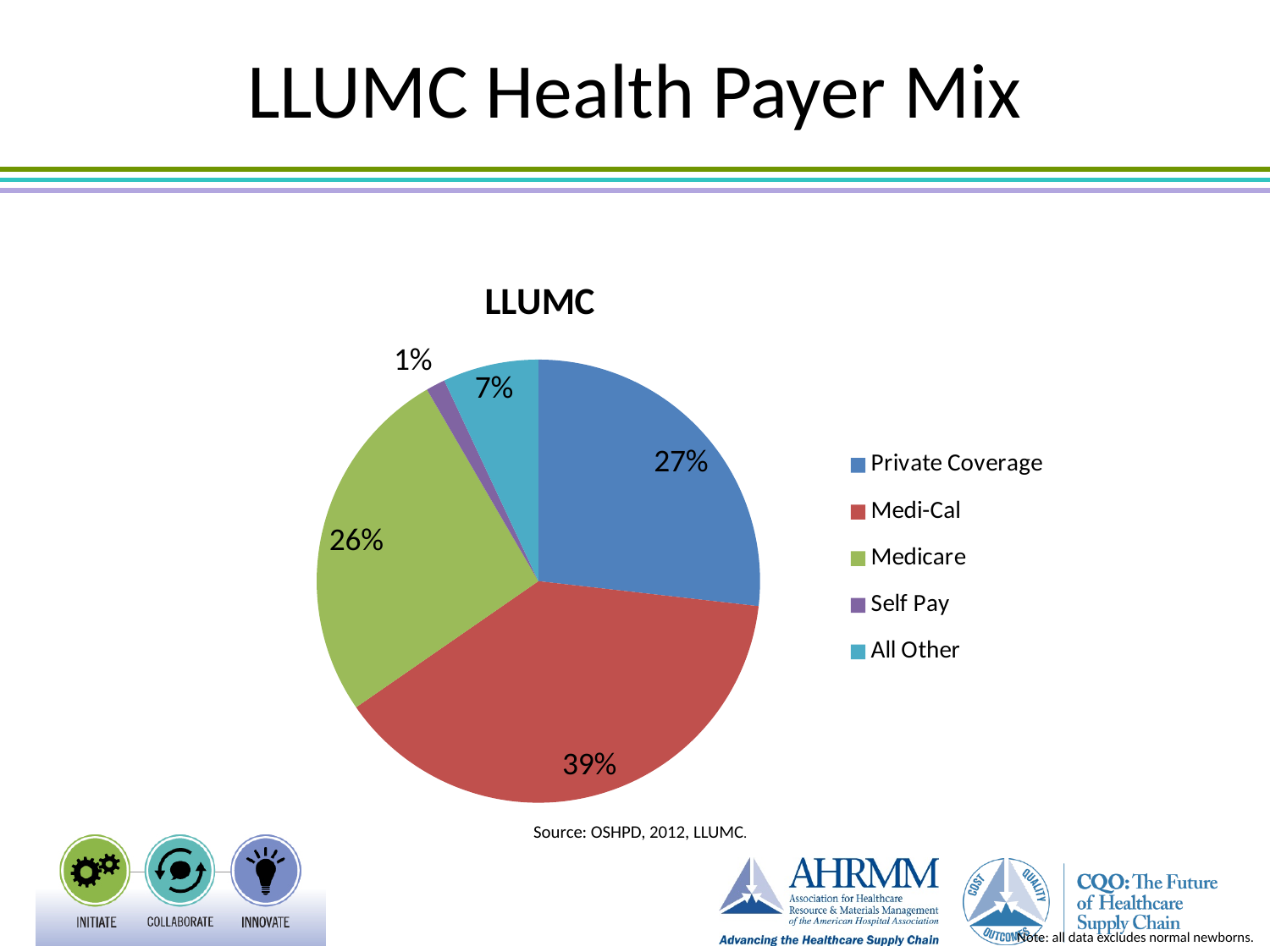
What share of the pie does Self Pay represent? 1% How many payer categories are shown in the pie chart? 5 What is the difference in percentage points between Medi-Cal and Private Coverage? 12 What share of the pie does Medi-Cal represent? 39% What share of the pie does Medicare represent? 26% Which is larger, the share for Medi-Cal or the share for Medicare? Medi-Cal Which payer category has the smallest share of the pie? Self Pay What share of the pie does All Other represent? 7% Which payer category has the largest share of the pie? Medi-Cal What share of the pie does Private Coverage represent? 27% What kind of chart is shown on the slide? Pie chart What is the title of the chart? LLUMC